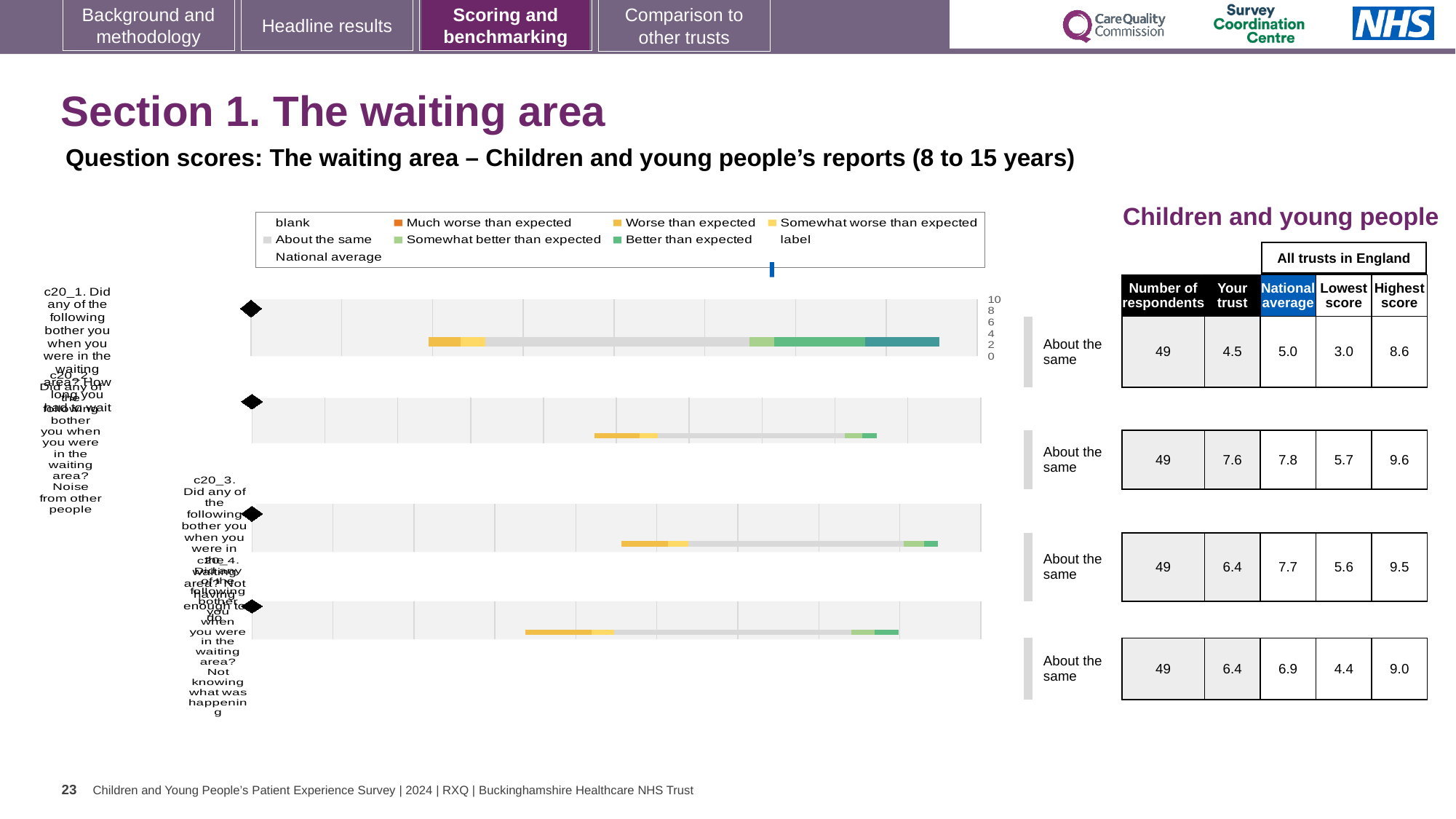
For the third question row (c20_3), which is larger: the 'Your trust' score or the national average? the national average (7.7) In the chart legend, what colour represents 'Much worse than expected'? orange Which question row has the highest 'Your trust' score in the table next to the charts? the second row (c20_2), 7.6 In the table next to the charts, what is the national average for the second question row (c20_2)? 7.8 In the table next to the charts, what is the 'Your trust' score for the first question row (c20_1)? 4.5 For the first question row (c20_1), what is the difference between the highest score (8.6) and the lowest score (3.0) in the table? 5.6 What is the heading above the table to the right of the charts? Children and young people In the table next to the charts, how many respondents are listed for each question row? 49 How many question rows (bar charts) are plotted on the slide? 4 What kind of chart is used to show the question scores on this slide? bar chart What benchmark label is shown beside each of the four bar charts? About the same Which question row has the lowest 'Your trust' score in the table next to the charts? the first row (c20_1), 4.5